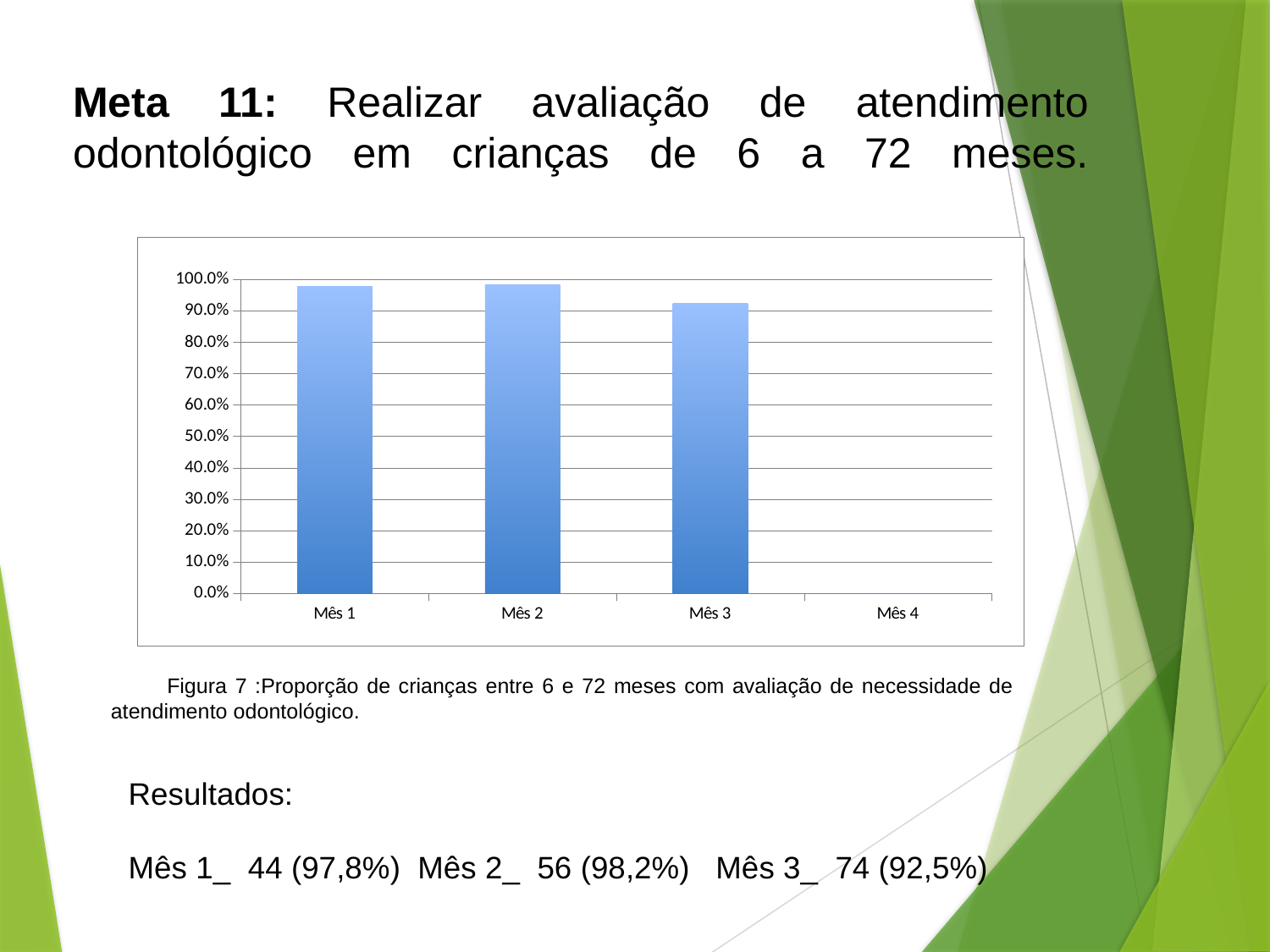
Which of the three plotted bars (Mês 1, Mês 2, Mês 3) is the lowest? Mês 3 According to the results text on the slide, what is the percentage for Mês 1? 97,8% Is the value for Mês 3 greater or less than 90.0%? greater How many categories are shown on the x axis of the chart? 4 What kind of chart is shown on the slide? bar chart According to the results text on the slide, what is the percentage for Mês 3? 92,5% Is the value for Mês 2 greater or less than 80.0%? greater What is the highest tick value shown on the y axis of the chart? 100.0% Which category on the x axis has no bar plotted? Mês 4 Is the value for Mês 1 greater or less than 90.0%? greater Which is larger, the value for Mês 2 or the value for Mês 3? Mês 2